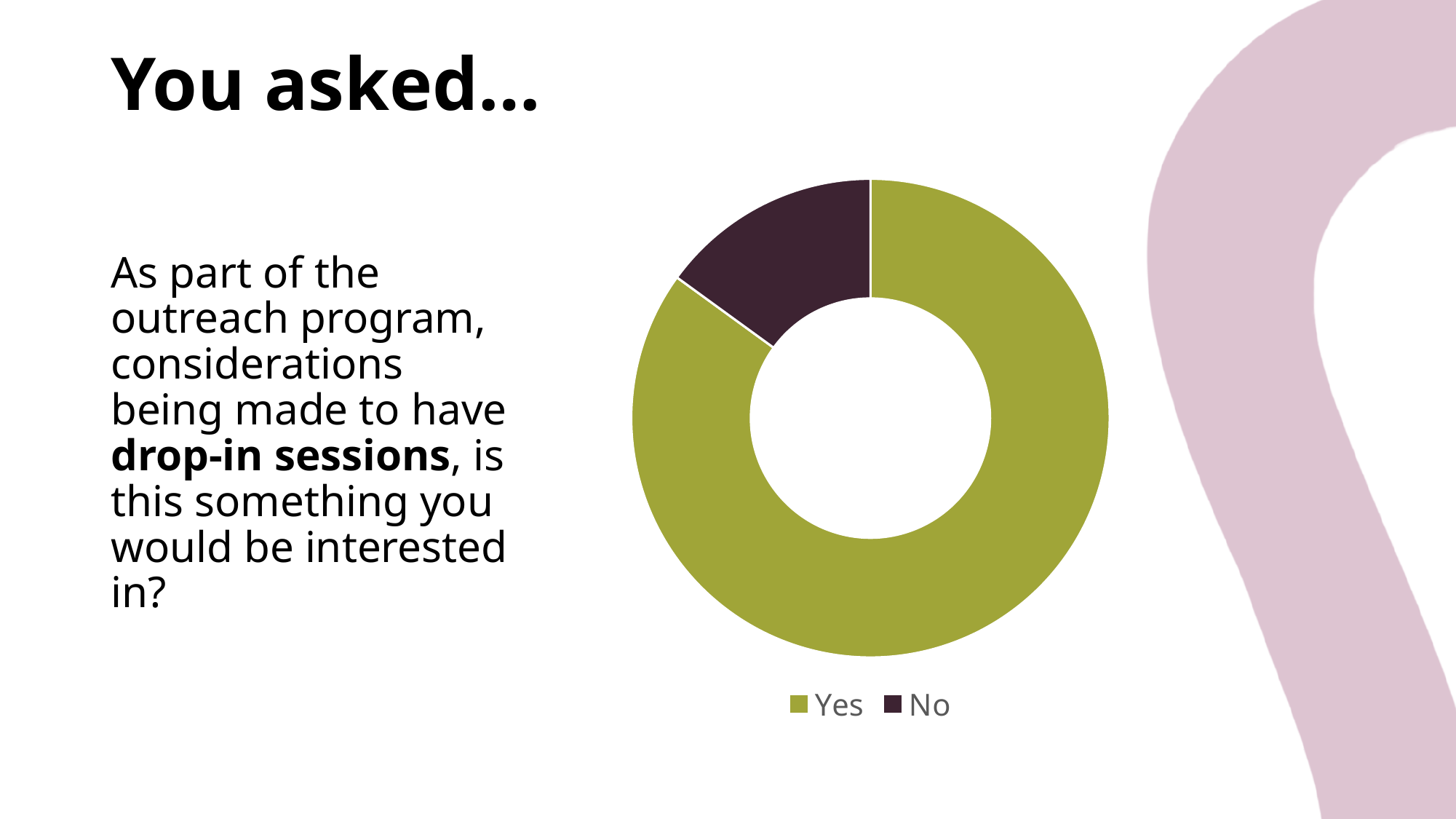
Which slice is larger, Yes or No? Yes How many categories does the chart's legend list? 2 Which category has the smallest slice in the chart? No What kind of chart is shown on the slide? Doughnut chart Which category has the largest slice in the chart? Yes Does the Yes slice take up more or less than half of the doughnut? More What colour is the Yes slice in the chart? Green What colour is the No slice in the chart? Dark purple